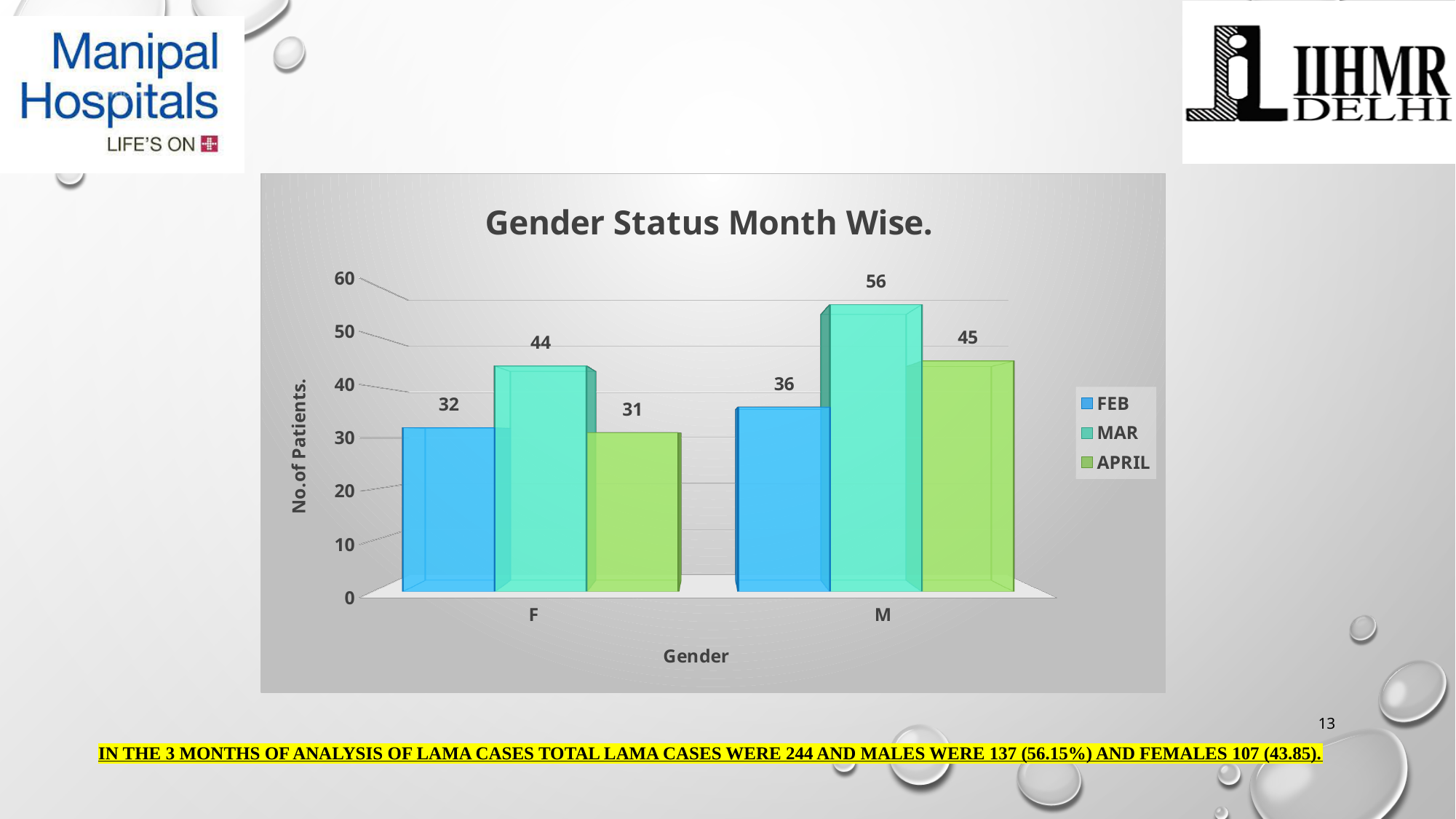
What is the number of patients for F in APRIL? 31 Which is larger, the FEB value for M or the FEB value for F? M What is the difference between the MAR values for M and F? 12 Which month has the lowest number of patients for F? APRIL What kind of chart is shown on the slide? Bar chart What is the number of patients for F in FEB? 32 What is the title of the chart? Gender Status Month Wise. How many gender categories are shown on the x axis? 2 How many series does the legend list? 3 What is the number of patients for M in APRIL? 45 What is the number of patients for M in MAR? 56 Which month has the highest number of patients for M? MAR